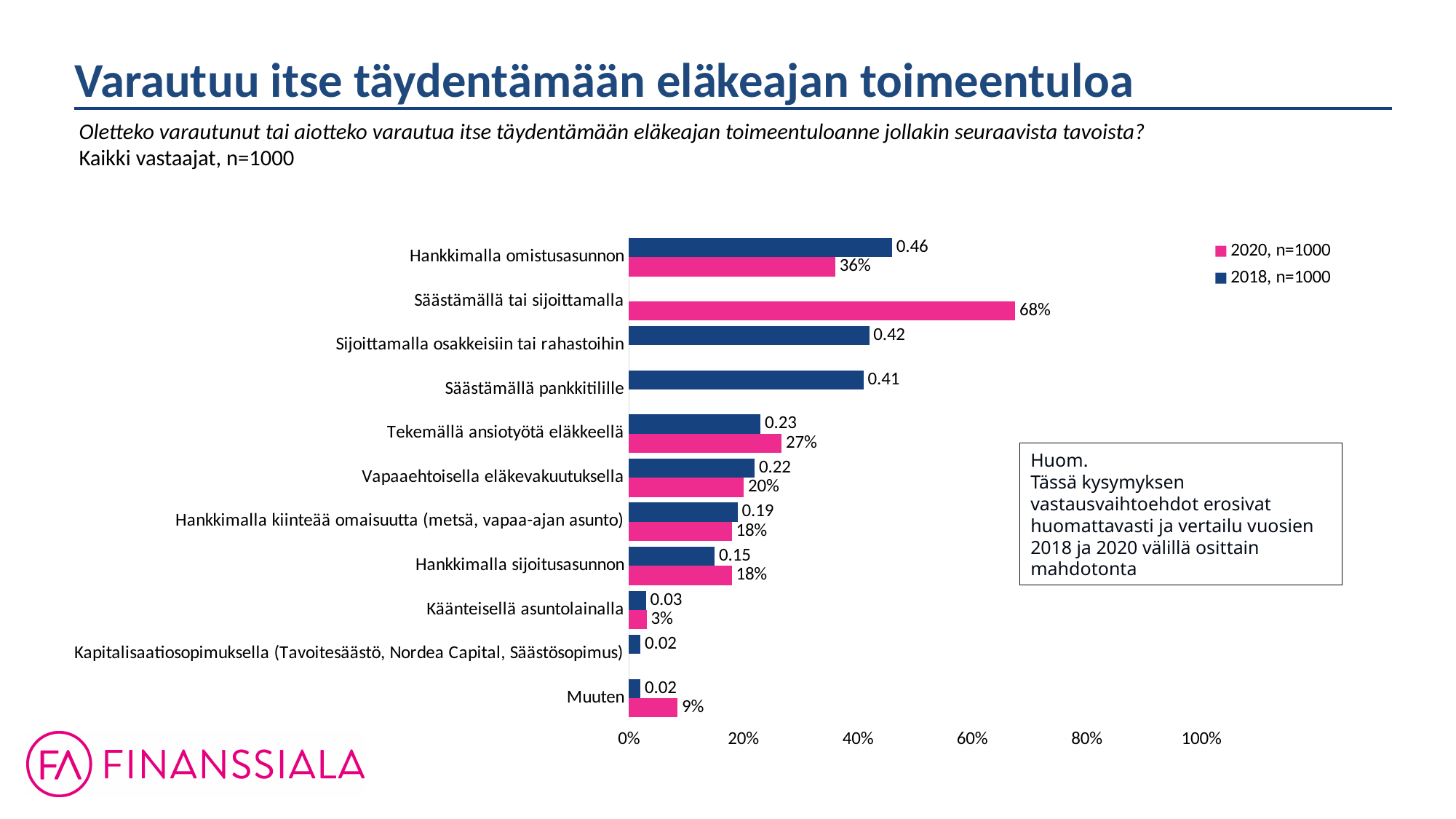
How many categories are shown on the y axis of the chart? 11 Which category has the lowest 2020 value? Käänteisellä asuntolainalla How many series does the legend list? 2 What is the difference in percentage points between the 2020 values for Säästämällä tai sijoittamalla and Hankkimalla omistusasunnon? 32 What kind of chart is shown on the slide? bar chart What is the 2018 value for Hankkimalla omistusasunnon? 0.46 What is the 2018 value for Säästämällä pankkitilille? 0.41 What is the 2020 value for Säästämällä tai sijoittamalla? 68% What is the 2020 value for Muuten? 9% Which category has the highest 2020 value? Säästämällä tai sijoittamalla For Tekemällä ansiotyötä eläkkeellä, which year has the larger value, 2018 or 2020? 2020 Is the 2020 value for Säästämällä tai sijoittamalla greater or less than 60%? greater